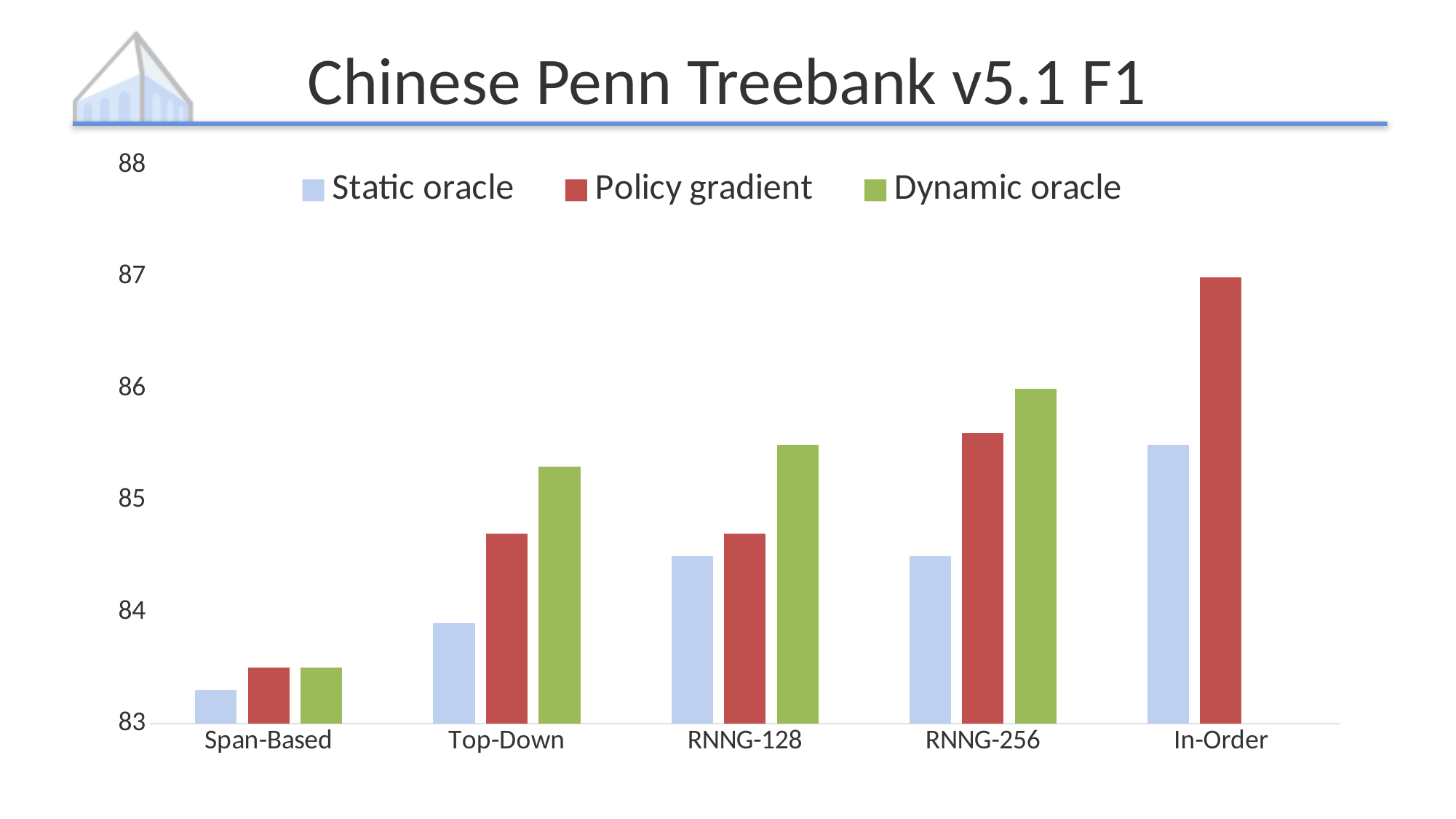
Which is larger, the Static oracle value for In-Order or the Static oracle value for RNNG-256? In-Order Is the Static oracle value for Span-Based greater or less than 84? less How many series does the legend list? 3 What kind of chart is shown on the slide? bar chart Which category has the lowest Static oracle value? Span-Based Which category has no Dynamic oracle bar? In-Order Which category has the highest Policy gradient value? In-Order How many parser categories are shown on the x axis? 5 Is the Dynamic oracle value for Top-Down greater or less than 85? greater Is the Static oracle value for RNNG-128 greater or less than 85? less Do the Static oracle values generally rise or fall from Span-Based to In-Order? rise